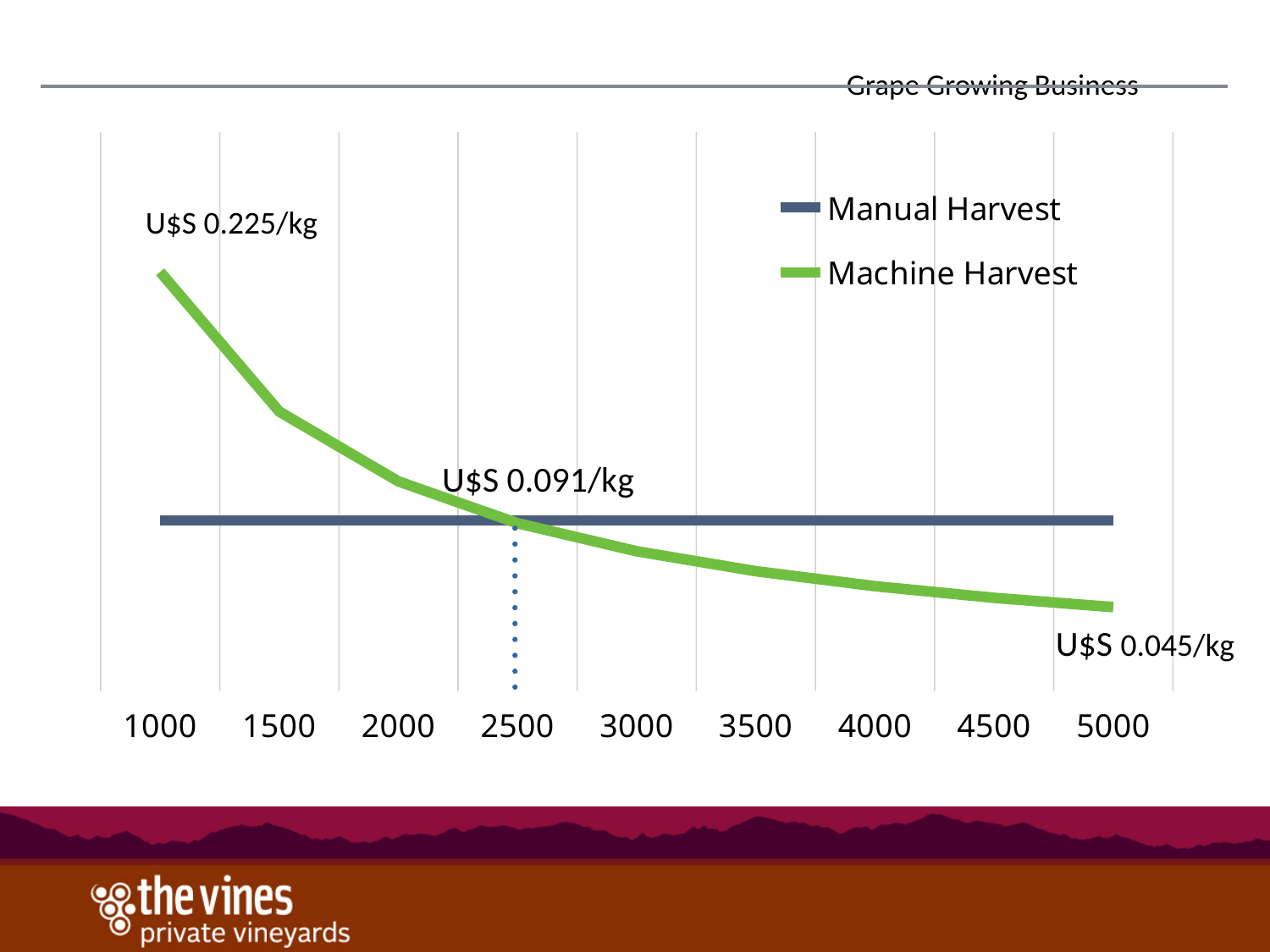
What is the Machine Harvest cost at 5000 on the x axis? U$S 0.045/kg What kind of chart is shown on the slide? line chart How many series does the legend list? 2 What colour is the Machine Harvest line in the legend? green What is the Machine Harvest cost at 1000 on the x axis? U$S 0.225/kg What is the difference between the Machine Harvest cost at 1000 and at 5000? U$S 0.180/kg At 5000 on the x axis, which series has the higher cost, Manual Harvest or Machine Harvest? Manual Harvest How many values are labelled on the x axis? 9 At 1000 on the x axis, which series has the higher cost, Manual Harvest or Machine Harvest? Machine Harvest Does the Machine Harvest line rise or fall as the x-axis values increase? fall What is the cost per kg for Manual Harvest? U$S 0.091/kg Does the Manual Harvest line rise, fall or stay flat across the x axis? stay flat